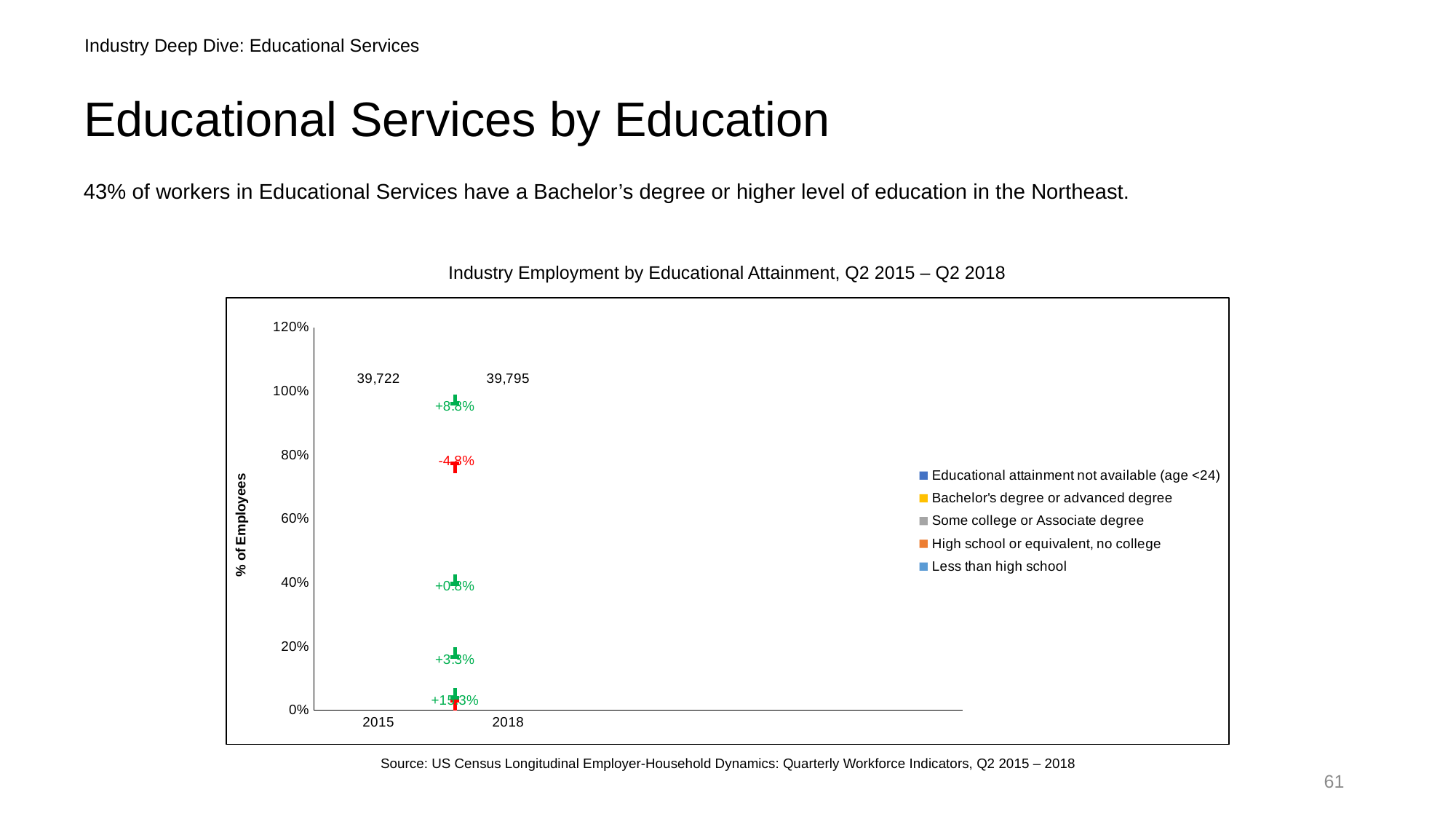
How many series does the legend list? 5 What is the difference between the totals printed for 2018 and 2015? 73 How many years are shown on the x axis? 2 What change value is printed in red near the 80% level between the two bars? -4.8% What total is printed above the 2018 bar? 39,795 Which year has the larger total printed above its bar, 2015 or 2018? 2018 What is the label on the y axis? % of Employees What total is printed above the 2015 bar? 39,722 What is the highest tick value shown on the y axis? 120% What is the title of the chart? Industry Employment by Educational Attainment, Q2 2015 – Q2 2018